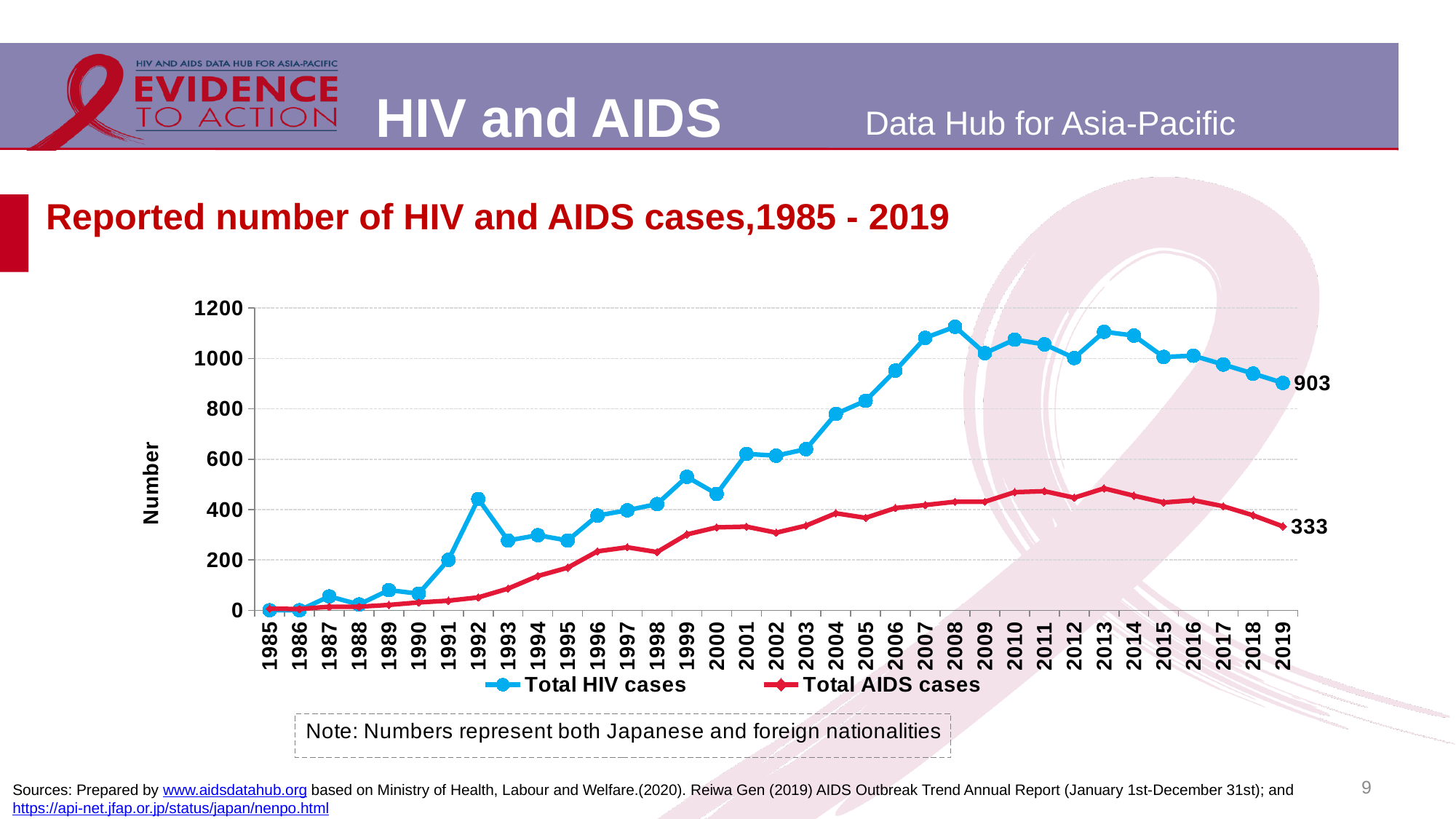
How many series does the legend list? 2 What kind of chart is shown on the slide? Line chart What is the title of the y axis? Number What is the difference between Total HIV cases and Total AIDS cases in 2019? 570 Is the value for Total HIV cases in 2008 greater or less than 1000? greater Do Total HIV cases rise or fall from 2014 to 2019? fall Is the value for Total AIDS cases in 1995 greater or less than 200? less In 2019, which series has the larger value, Total HIV cases or Total AIDS cases? Total HIV cases How many years are plotted along the x axis? 35 What is the value for Total HIV cases in 2019? 903 Is the value for Total HIV cases in 1992 greater or less than 400? greater What is the value for Total AIDS cases in 2019? 333